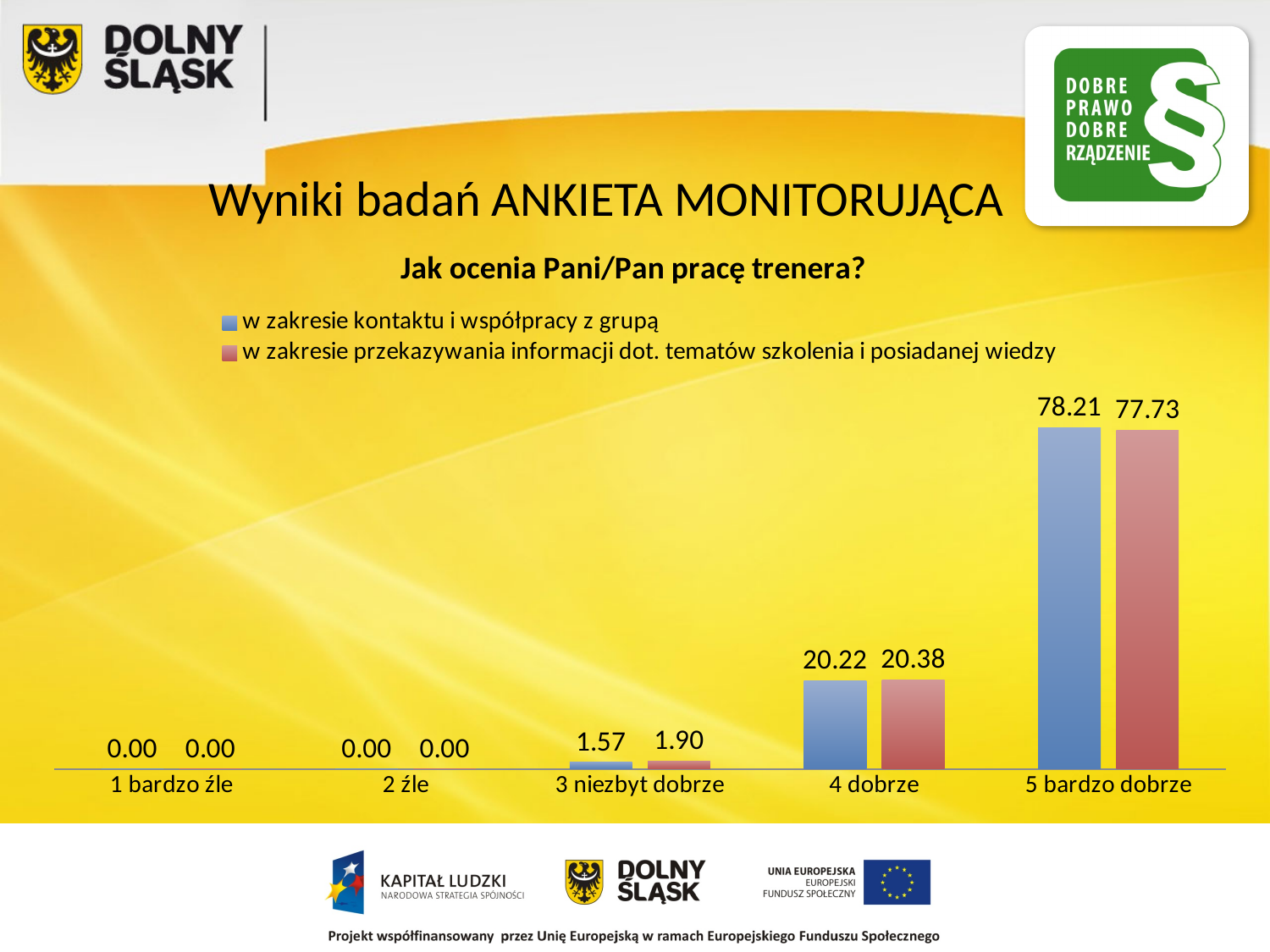
For '4 dobrze', which series has the larger value? w zakresie przekazywania informacji dot. tematów szkolenia i posiadanej wiedzy What is the value for '5 bardzo dobrze' in the series 'w zakresie kontaktu i współpracy z grupą'? 78.21 What is the value for '1 bardzo źle' in the series 'w zakresie przekazywania informacji dot. tematów szkolenia i posiadanej wiedzy'? 0.00 How many categories are shown on the x axis? 5 What is the difference between the two series' values for '5 bardzo dobrze'? 0.48 What is the title of the chart? Jak ocenia Pani/Pan pracę trenera? What is the value for '4 dobrze' in the series 'w zakresie przekazywania informacji dot. tematów szkolenia i posiadanej wiedzy'? 20.38 What kind of chart is shown on the slide? bar chart How many series does the legend list? 2 What is the difference between the two series' values for '3 niezbyt dobrze'? 0.33 Which category has the highest value in the series 'w zakresie kontaktu i współpracy z grupą'? 5 bardzo dobrze What is the value for '3 niezbyt dobrze' in the series 'w zakresie kontaktu i współpracy z grupą'? 1.57